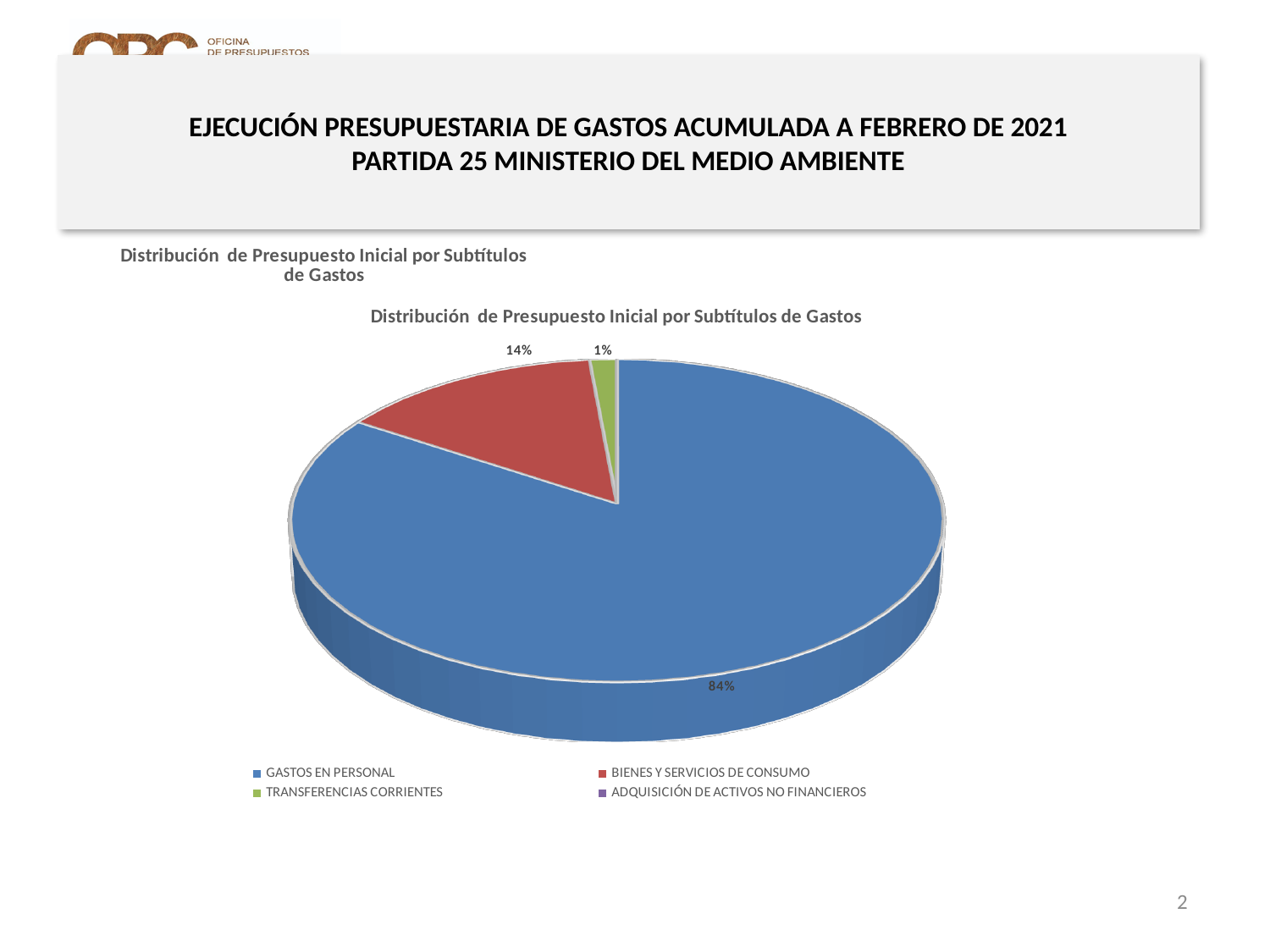
Which category has the largest slice of the pie? GASTOS EN PERSONAL What percentage is shown for TRANSFERENCIAS CORRIENTES? 1% Which is larger, the slice for BIENES Y SERVICIOS DE CONSUMO or the slice for TRANSFERENCIAS CORRIENTES? BIENES Y SERVICIOS DE CONSUMO What kind of chart is shown on the slide? Pie chart What is the difference in percentage points between BIENES Y SERVICIOS DE CONSUMO and TRANSFERENCIAS CORRIENTES? 13 percentage points What is the difference in percentage points between GASTOS EN PERSONAL and BIENES Y SERVICIOS DE CONSUMO? 70 percentage points How many categories does the legend list? 4 What share of the pie does GASTOS EN PERSONAL represent? 84% What is the title of the chart? Distribución de Presupuesto Inicial por Subtítulos de Gastos What percentage is shown for BIENES Y SERVICIOS DE CONSUMO? 14% What colour is the slice for GASTOS EN PERSONAL? Blue